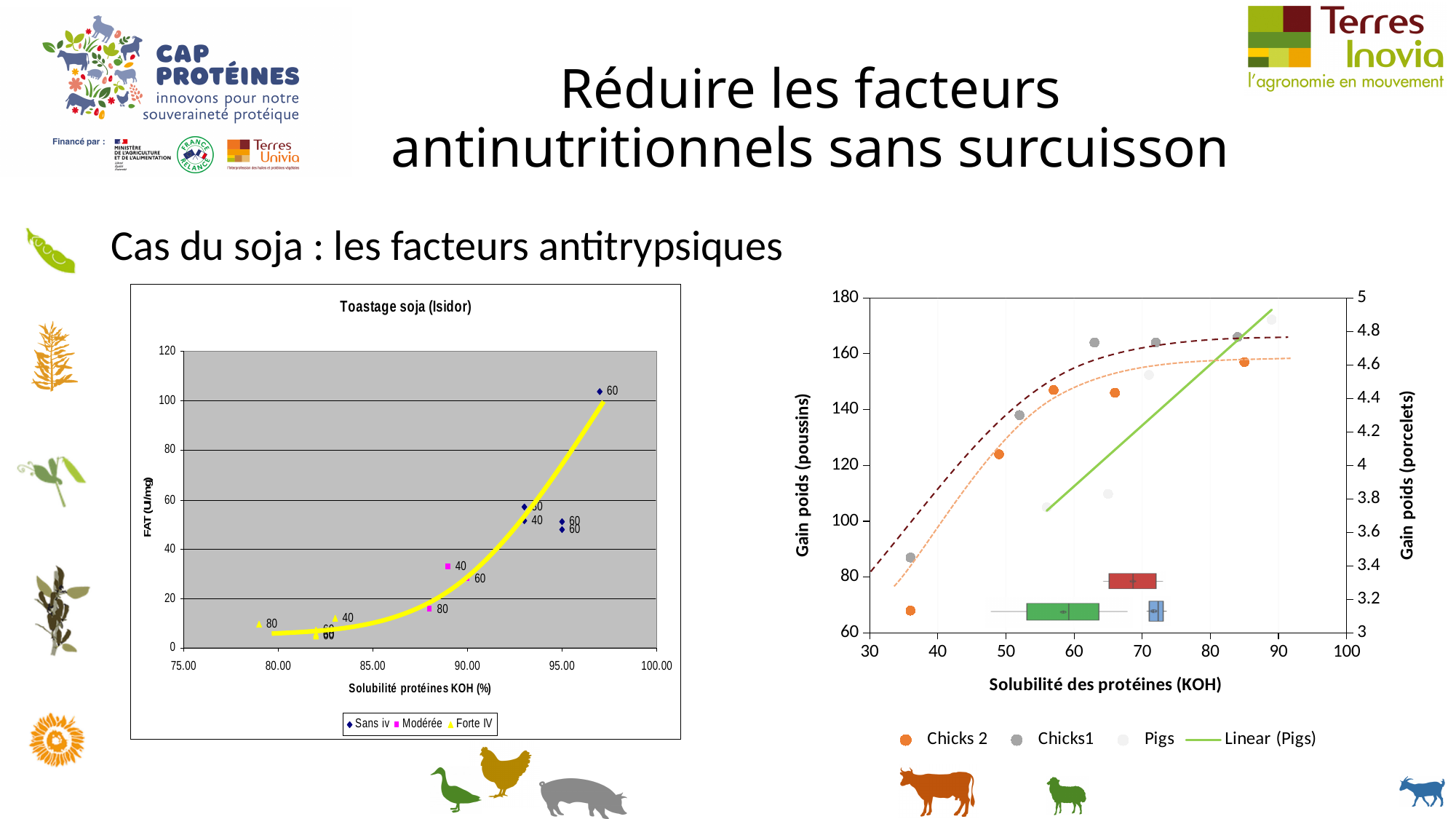
In the right chart, is the 'Chicks1' value at the lowest solubility (around 36) greater or less than 80? greater In the right chart, does the 'Linear (Pigs)' line rise or fall as solubility increases? rise In the right chart, is the 'Chicks 2' value at the lowest solubility (around 36) greater or less than 80? less In the left chart 'Toastage soja (Isidor)', is the FAT value of the highest 'Sans iv' point (labelled 60, near 97% solubility) greater or less than 80? greater What is the title of the left chart? Toastage soja (Isidor) In the left chart 'Toastage soja (Isidor)', how many series does the legend list? 3 What kind of chart is the right chart? scatter chart In the right chart, how many series does the legend list? 4 In the left chart 'Toastage soja (Isidor)', what is the label of the vertical axis? FAT (U/mg) In the right chart, what is the title of the horizontal axis? Solubilité des protéines (KOH) What kind of chart is the left chart titled 'Toastage soja (Isidor)'? scatter chart